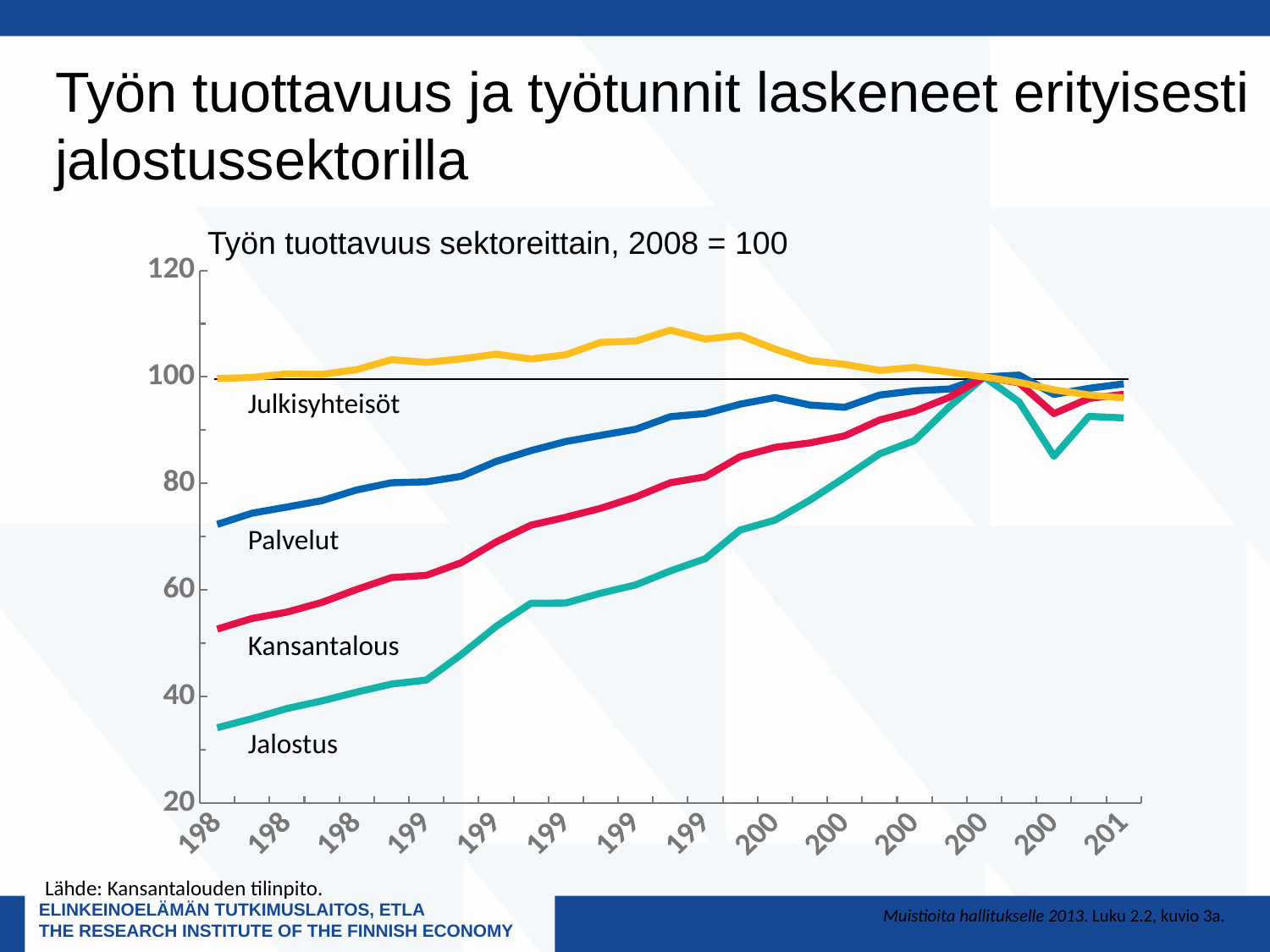
At what value is the horizontal reference line drawn across the chart? 100 Which series is the lowest at the left edge of the chart? Jalostus Does the Jalostus line generally rise or fall from the left edge of the chart up to the point where all lines meet at 100? Rise At the left edge of the chart, is the value for Palvelut greater or less than 60? greater How many series (sectors) are plotted in the chart? 4 At the left edge of the chart, which is higher, Palvelut or Kansantalous? Palvelut At its peak, is the value for Julkisyhteisöt greater or less than 100? greater At the left edge of the chart, is the value for Jalostus greater or less than 40? less What kind of chart is shown on the slide? Line chart Which series is the highest at the left edge of the chart? Julkisyhteisöt What is the title of the chart? Työn tuottavuus sektoreittain, 2008 = 100